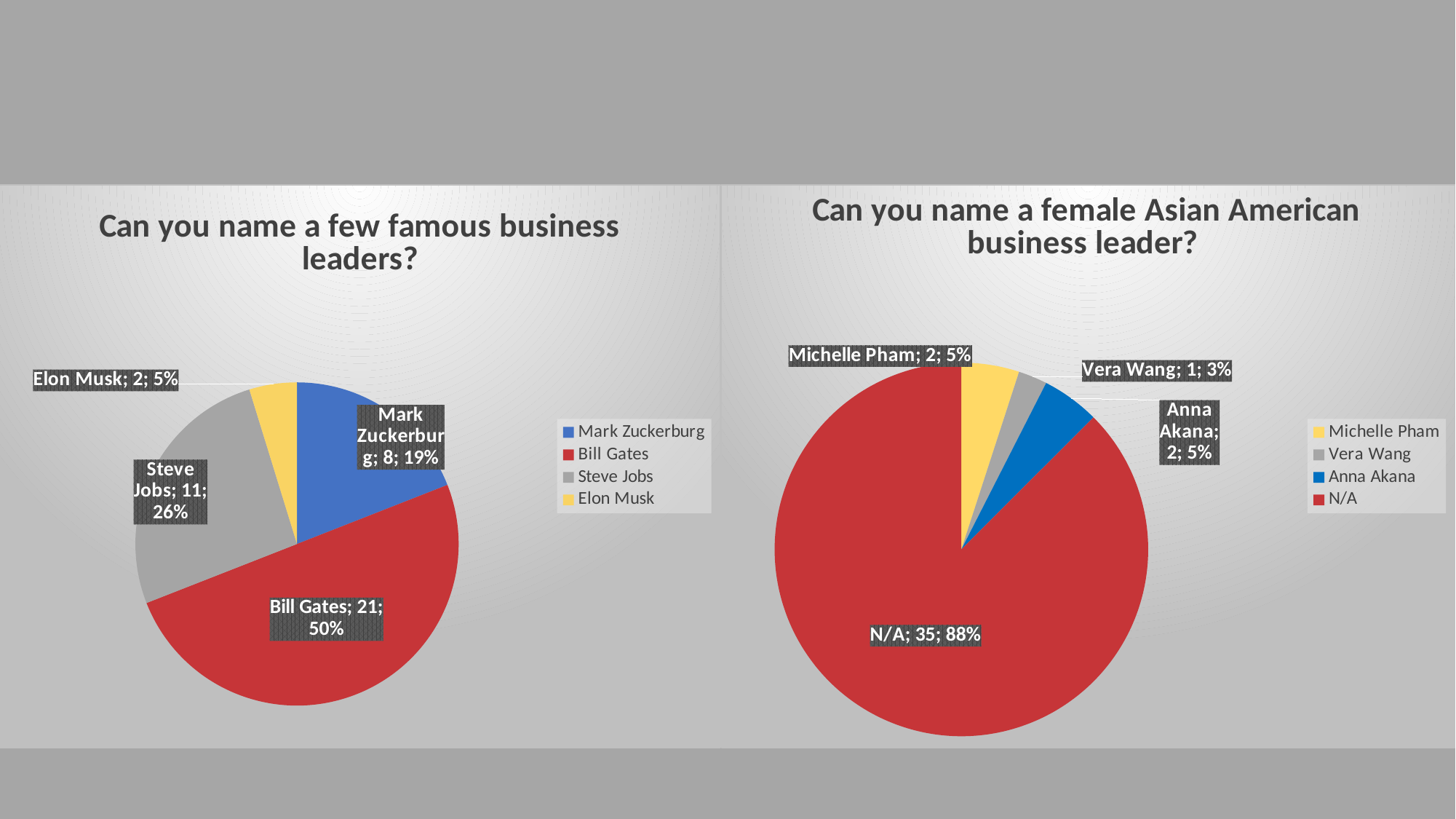
In the chart titled "Can you name a female Asian American business leader?", what percentage share does Vera Wang have? 3% In the chart titled "Can you name a female Asian American business leader?", which category has the smallest slice? Vera Wang What kind of chart is the one titled "Can you name a female Asian American business leader?"? Pie chart In the chart titled "Can you name a few famous business leaders?", what is the difference between the counts for Bill Gates and Mark Zuckerburg? 13 In the chart titled "Can you name a female Asian American business leader?", what colour is the N/A slice? Red In the chart titled "Can you name a few famous business leaders?", what count is shown for Bill Gates? 21 In the chart titled "Can you name a female Asian American business leader?", which is larger, the count for Michelle Pham or the count for Vera Wang? Michelle Pham In the chart titled "Can you name a few famous business leaders?", which category has the smallest slice? Elon Musk In the chart titled "Can you name a few famous business leaders?", what percentage share does Steve Jobs have? 26% In the chart titled "Can you name a female Asian American business leader?", what count is shown for N/A? 35 In the chart titled "Can you name a few famous business leaders?", how many categories does the legend list? 4 In the chart titled "Can you name a few famous business leaders?", which category has the largest slice? Bill Gates